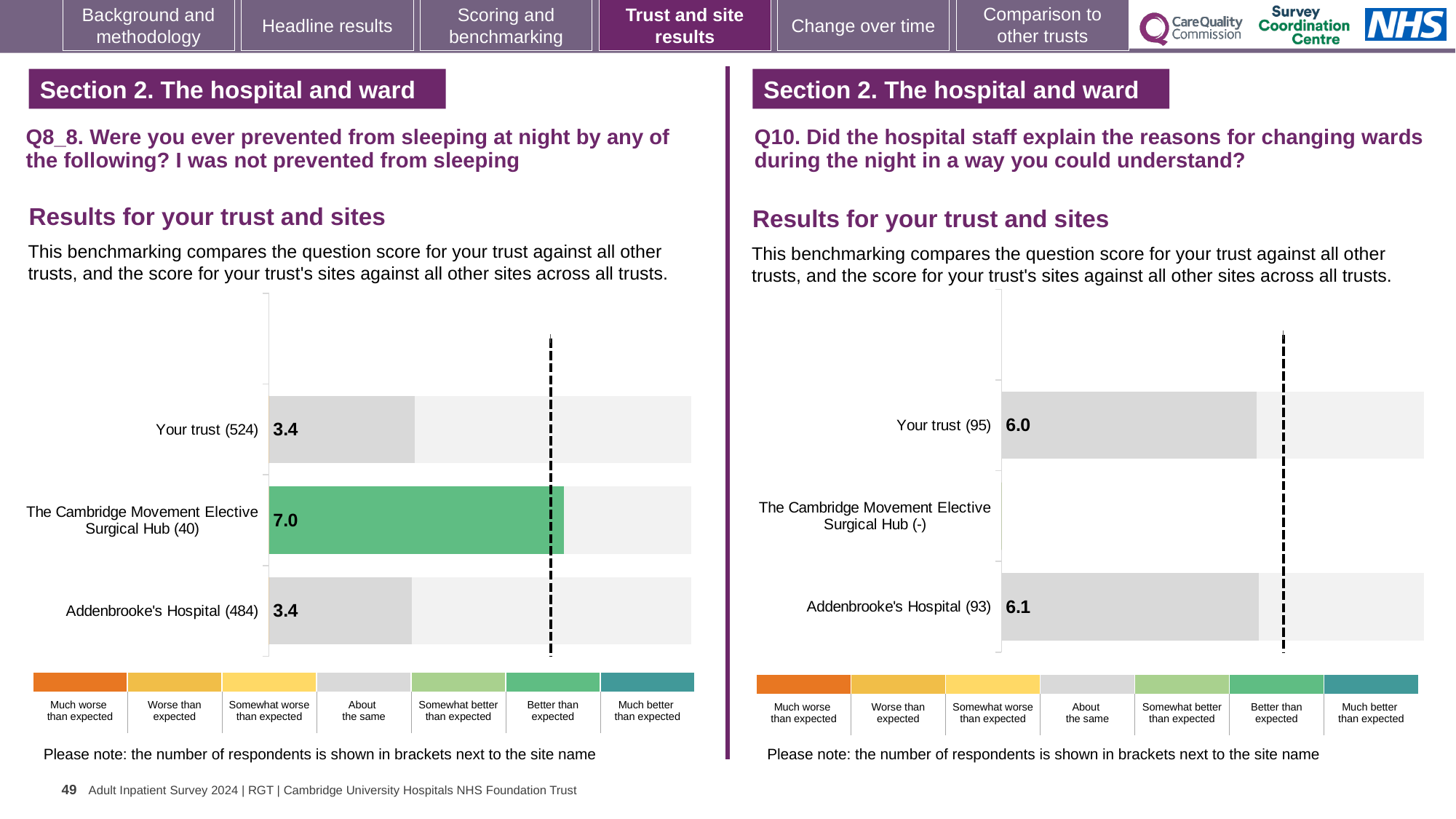
In the Q10 chart on the right, what is the difference between the score for Addenbrooke's Hospital (93) and the score for Your trust (95)? 0.1 In the Q8_8 chart on the left, what is the difference between the score for The Cambridge Movement Elective Surgical Hub (40) and the score for Addenbrooke's Hospital (484)? 3.6 In the Q8_8 chart on the left, which benchmark category does the green colour of The Cambridge Movement Elective Surgical Hub bar represent? Better than expected In the Q10 chart on the right, which is larger: the score for Addenbrooke's Hospital (93) or the score for Your trust (95)? Addenbrooke's Hospital (93) In the Q8_8 chart on the left, which site has the highest score? The Cambridge Movement Elective Surgical Hub (40) What type of chart is used for the Q10 results on the right? Bar chart In the Q8_8 chart on the left, what is the score for The Cambridge Movement Elective Surgical Hub (40)? 7.0 In the Q10 chart on the right, what is the score for Your trust (95)? 6.0 In the Q8_8 chart on the left, how many bars are plotted? 3 In the Q8_8 chart on the left, what is the score for Addenbrooke's Hospital (484)? 3.4 In the Q10 chart on the right, what is the score for Addenbrooke's Hospital (93)? 6.1 In the Q8_8 chart on the left, what is the score for Your trust (524)? 3.4